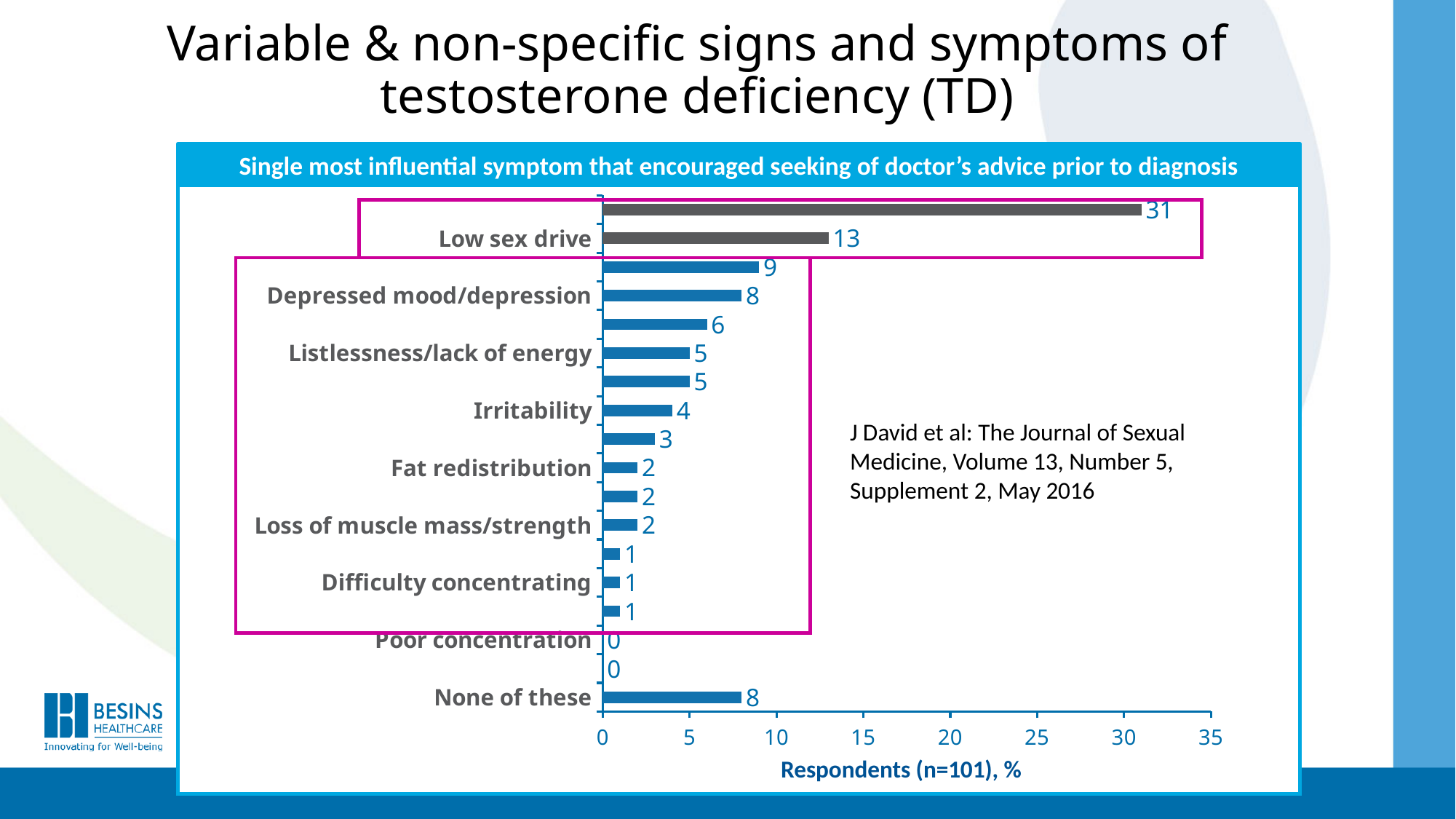
What is the value for Difficulty concentrating? 1 Is the value for Low sex drive greater or less than 10? greater What is the value for None of these? 8 What is the value for Listlessness/lack of energy? 5 What is the difference between the values for Low sex drive and Depressed mood/depression? 5 What is the value for Depressed mood/depression? 8 What is the value for Irritability? 4 What kind of chart is shown on the slide? Bar chart What is the value for Loss of muscle mass/strength? 2 What is the value for Low sex drive? 13 What is the label of the horizontal axis of the chart? Respondents (n=101), % Which has a larger value, Irritability or Fat redistribution? Irritability